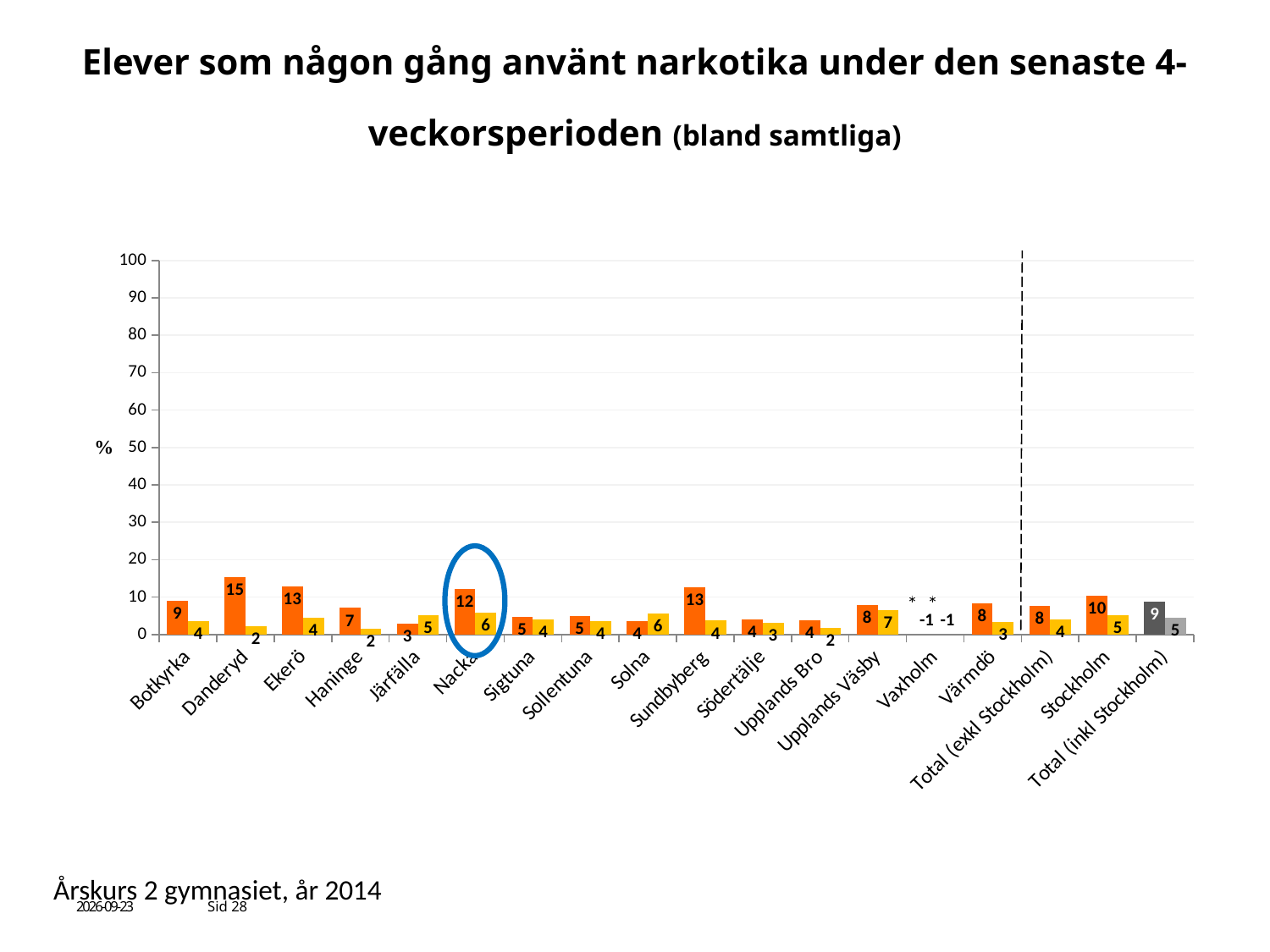
How many categories are shown on the x axis? 18 What is the difference between the orange and yellow bars for Danderyd? 13 What is the difference between the orange bars for Ekerö and Haninge? 6 What is the value of the yellow bar for Nacka? 6 Is the orange bar for Sundbyberg greater or less than 10? greater Which category has the highest yellow bar? Upplands Väsby Which is larger for Solna, the orange bar or the yellow bar? the yellow bar What is the value of the orange bar for Stockholm? 10 What is the value of the yellow bar for Upplands Väsby? 7 Which category has the highest orange bar? Danderyd What is the value of the orange bar for Danderyd? 15 What kind of chart is shown on the slide? bar chart